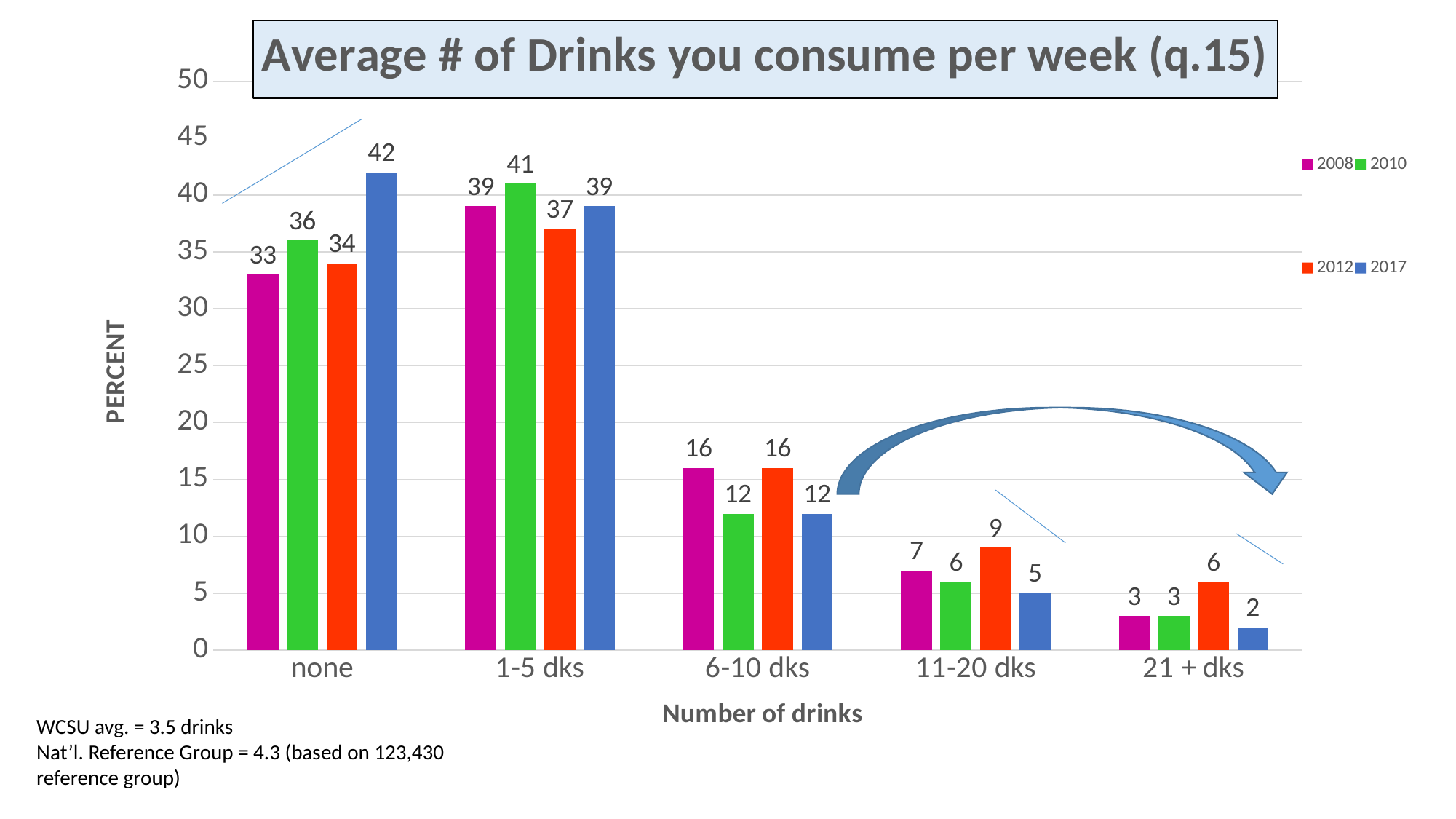
What kind of chart is shown on the slide? bar chart What is the label of the y axis? PERCENT What is the title of the chart? Average # of Drinks you consume per week (q.15) Which category has the lowest value for the 2017 series? 21 + dks How many series does the legend list? 4 Which category has the highest value for the 2008 series? 1-5 dks What is the value for 2012 in the '1-5 dks' category? 37 What is the value for 2017 in the 'none' category? 42 What is the value for 2010 in the '6-10 dks' category? 12 Which is larger in the '11-20 dks' category: the 2012 value or the 2017 value? 2012 How many categories are shown on the x axis? 5 What is the difference between the 2017 and 2008 values in the 'none' category? 9